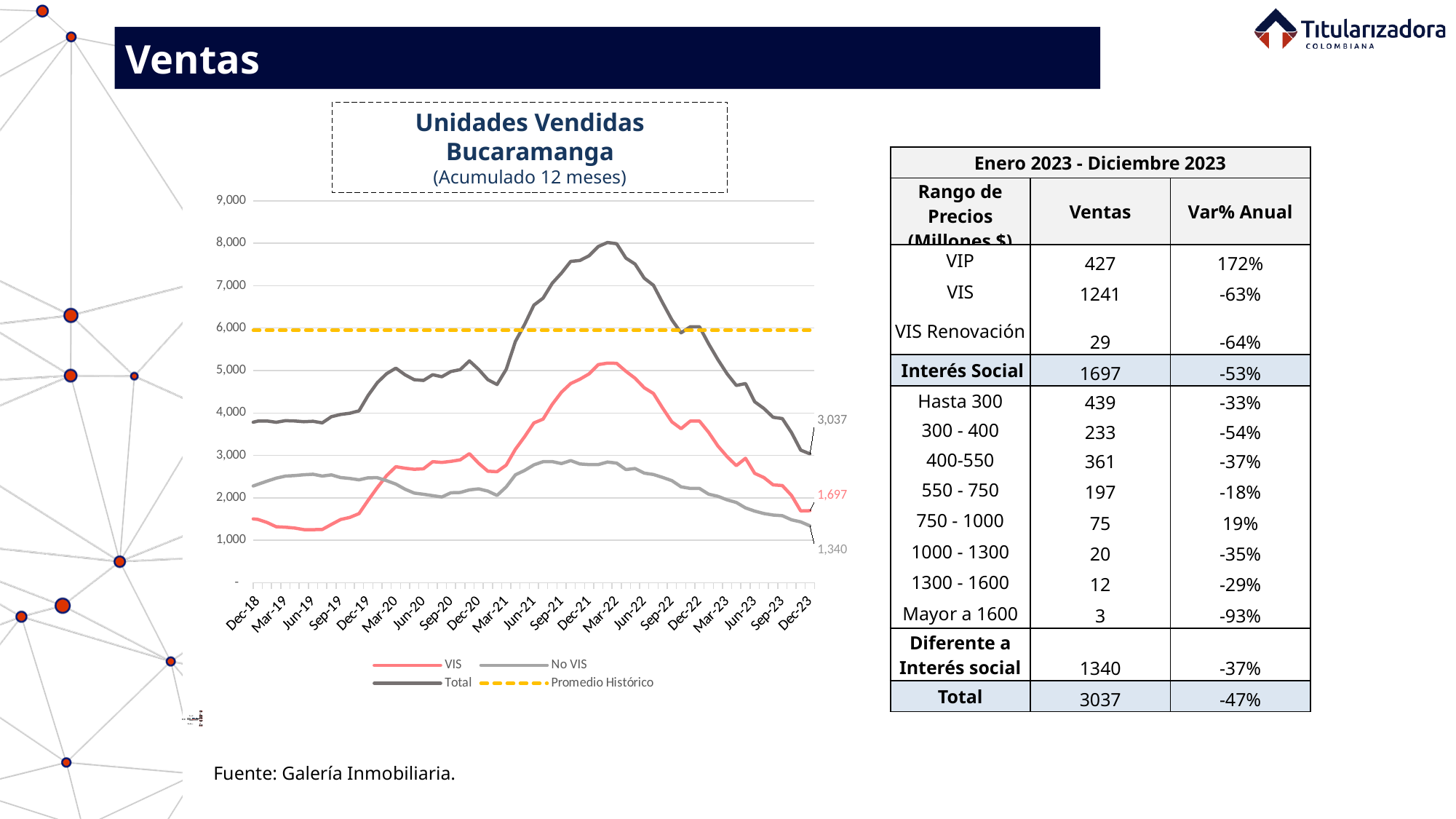
In the Unidades Vendidas Bucaramanga chart, is the Promedio Histórico line greater or less than 5,000? greater In the Unidades Vendidas Bucaramanga chart, what is the value of the No VIS series at Dec-23? 1,340 In the Unidades Vendidas Bucaramanga chart, does the Total series rise or fall between Mar-22 and Dec-23? Fall In the Unidades Vendidas Bucaramanga chart, what is the value of the Total series at Dec-23? 3,037 In the Unidades Vendidas Bucaramanga chart, what is the difference between the VIS and No VIS values at Dec-23? 357 In the Unidades Vendidas Bucaramanga chart, which series is drawn as a dashed yellow line? Promedio Histórico What kind of chart is the Unidades Vendidas Bucaramanga chart? Line chart In the Unidades Vendidas Bucaramanga chart, is the value of the VIS series at Dec-18 greater or less than 2,000? less In the Unidades Vendidas Bucaramanga chart, what is the value of the VIS series at Dec-23? 1,697 How many series does the legend of the Unidades Vendidas Bucaramanga chart list? 4 In the Unidades Vendidas Bucaramanga chart, which is larger at Dec-23: VIS or No VIS? VIS In the Unidades Vendidas Bucaramanga chart, is the value of the Total series at Mar-22 greater or less than 7,000? greater